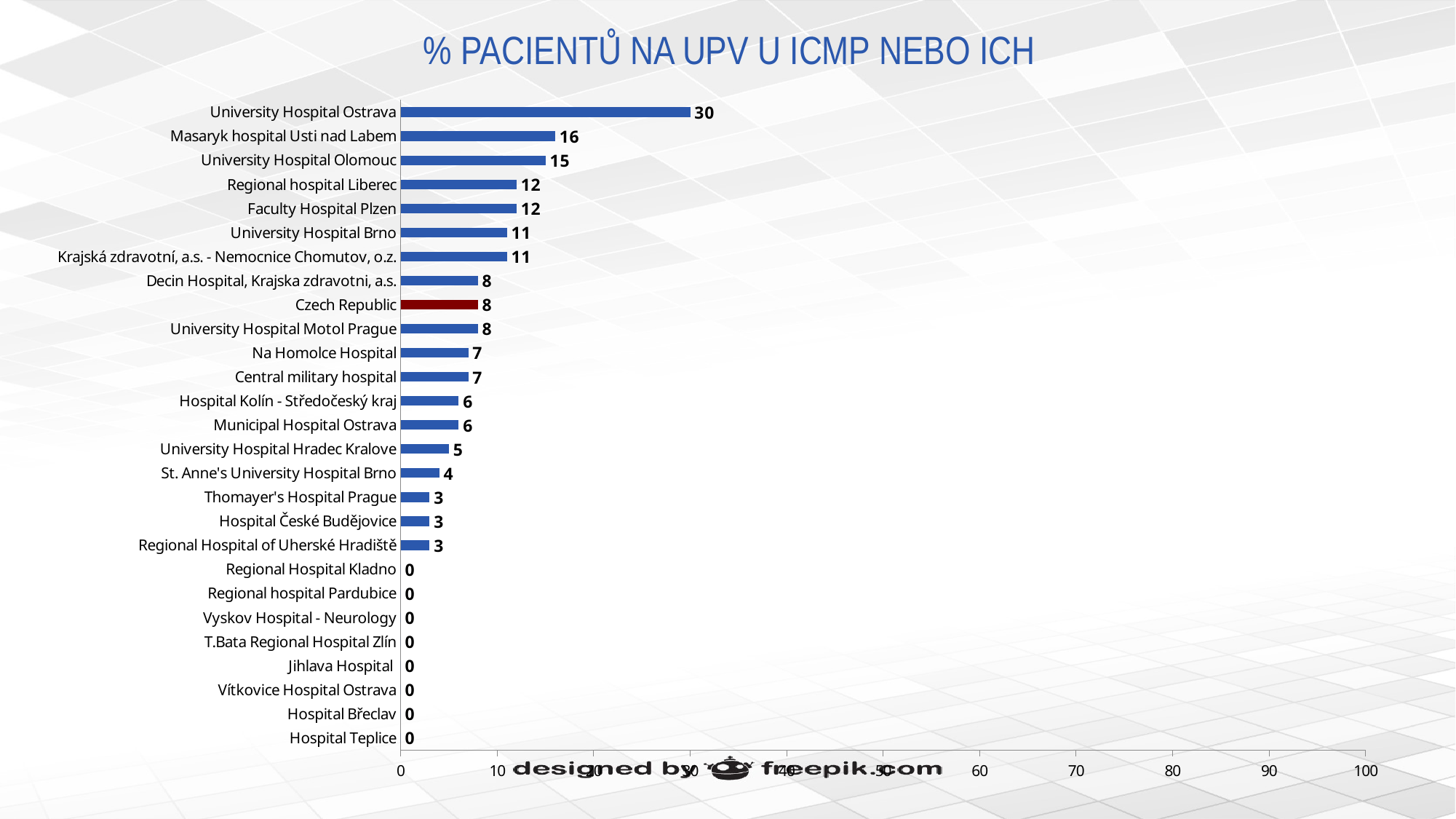
What kind of chart is shown on the slide? bar chart What is the difference between the values for University Hospital Ostrava and University Hospital Olomouc? 15 What is the value for University Hospital Hradec Kralove? 5 Which category has the highest value? University Hospital Ostrava What is the value for Masaryk hospital Usti nad Labem? 16 Which is larger, the value for Regional hospital Liberec or the value for University Hospital Brno? Regional hospital Liberec What is the value for Czech Republic? 8 Which category's bar is coloured dark red instead of blue? Czech Republic How many categories have a value of 0? 8 Is the value for University Hospital Ostrava greater or less than 20? greater What is the value for University Hospital Ostrava? 30 How many categories are shown on the chart? 27